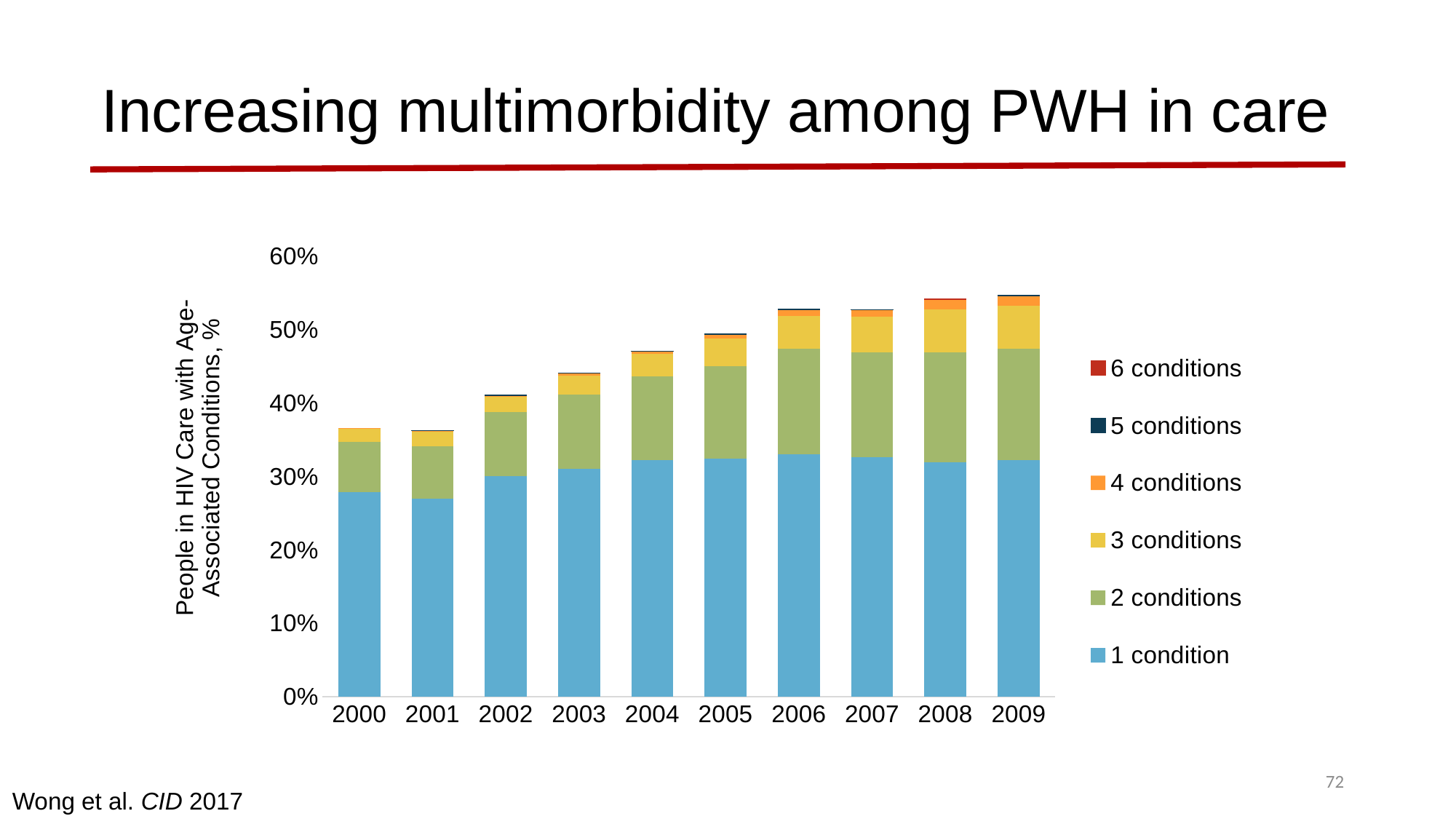
Do the total stacked bar heights generally rise or fall from 2000 to 2009? Rise How many years (categories) are shown on the x axis? 10 What kind of chart is shown on the slide? Stacked bar chart Is the value for 1 condition in 2006 greater or less than 30%? greater How many series does the legend list? 6 Which year has the taller stacked bar, 2000 or 2009? 2009 Is the total height of the stacked bar for 2009 greater or less than 50%? greater Which year has the larger value for 1 condition, 2001 or 2006? 2006 Is the total height of the stacked bar for 2001 greater or less than 40%? less What is the title of the slide's chart? Increasing multimorbidity among PWH in care